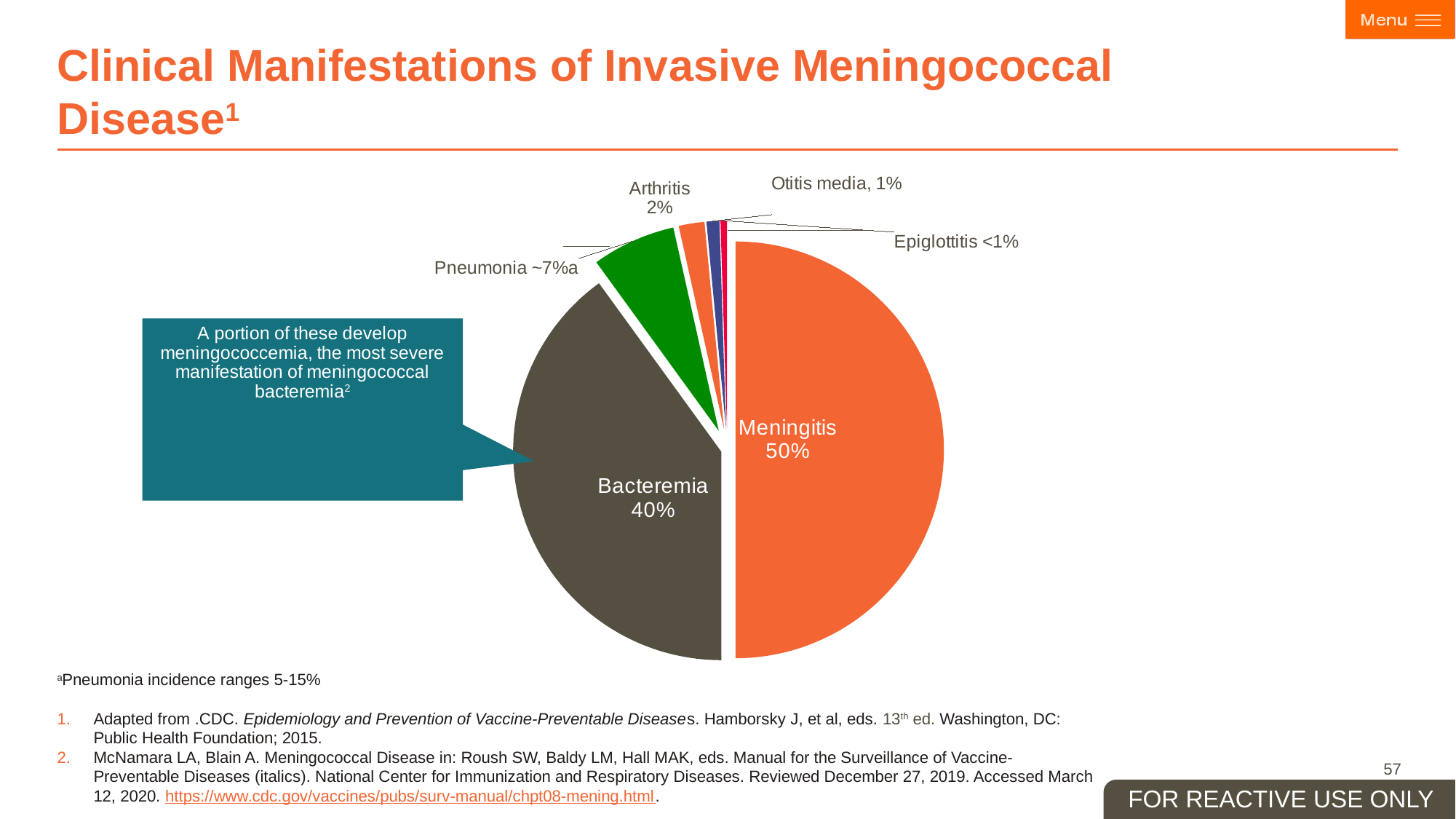
What percentage is shown for Arthritis? 2% What is the title of the slide containing the chart? Clinical Manifestations of Invasive Meningococcal Disease What percentage of invasive meningococcal disease cases are meningitis according to the pie chart? 50% Which clinical manifestation has the largest slice of the pie chart? Meningitis Which is larger, the Bacteremia slice or the Arthritis slice? Bacteremia What type of chart is used on this slide? Pie chart Which slice does the teal callout box about meningococcemia point to? Bacteremia By how many percentage points does Meningitis exceed Bacteremia? 10 percentage points Which clinical manifestation has the smallest slice of the pie chart? Epiglottitis How many clinical manifestations are shown as slices in the pie chart? 6 What percentage does the Bacteremia slice represent? 40% What percentage is shown for Otitis media? 1%